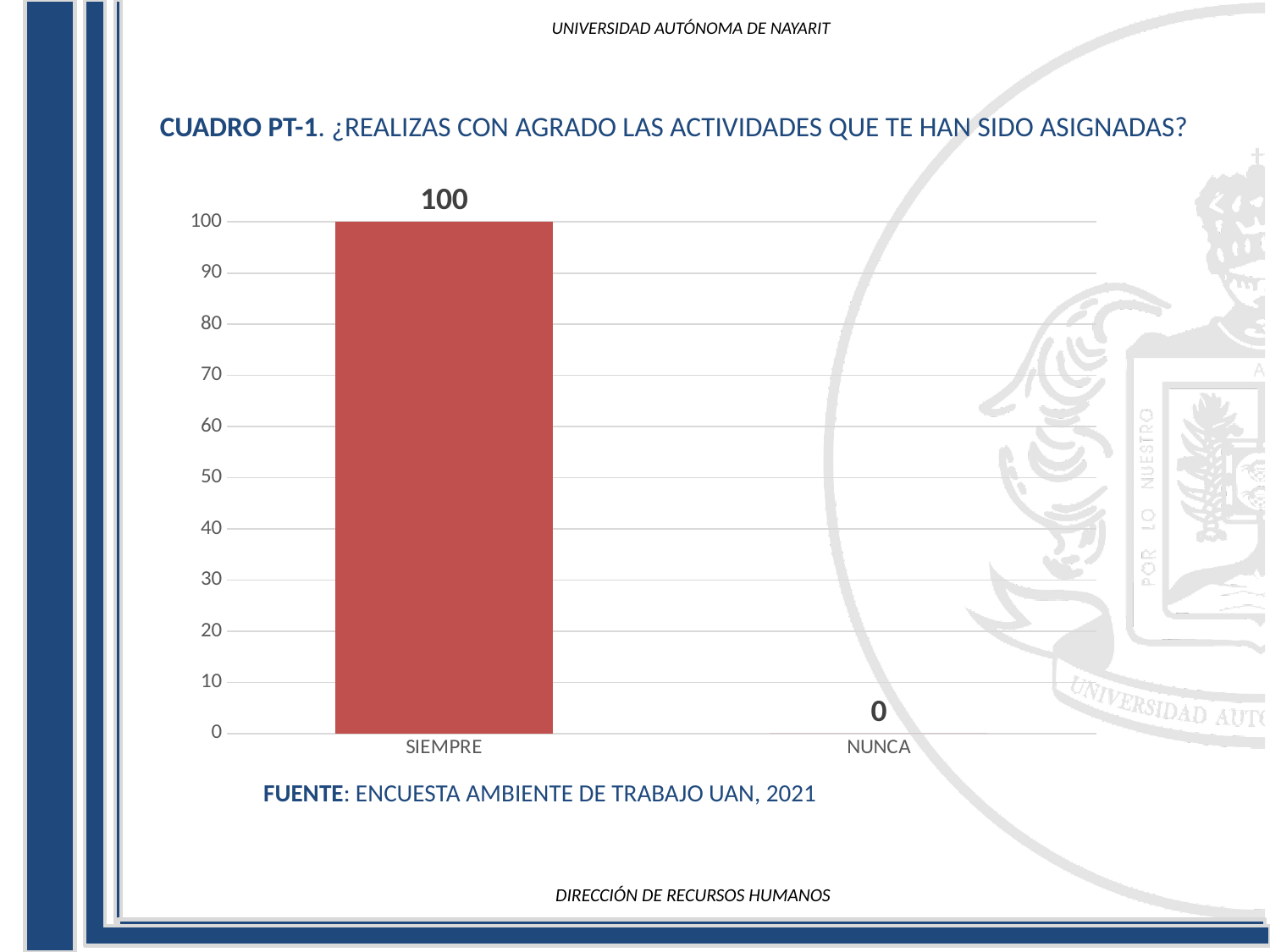
What is the value for NUNCA? 0 Do the values rise or fall from SIEMPRE to NUNCA? fall What kind of chart is shown on the slide? bar chart Which is larger, the value for SIEMPRE or the value for NUNCA? SIEMPRE What is the value for SIEMPRE? 100 What is the source cited below the chart? ENCUESTA AMBIENTE DE TRABAJO UAN, 2021 Which category has the highest value? SIEMPRE Is the value for SIEMPRE greater or less than 50? greater What is the highest value shown on the vertical axis? 100 Which category has the lowest value? NUNCA How many categories are shown on the x axis? 2 What is the difference between the values for SIEMPRE and NUNCA? 100